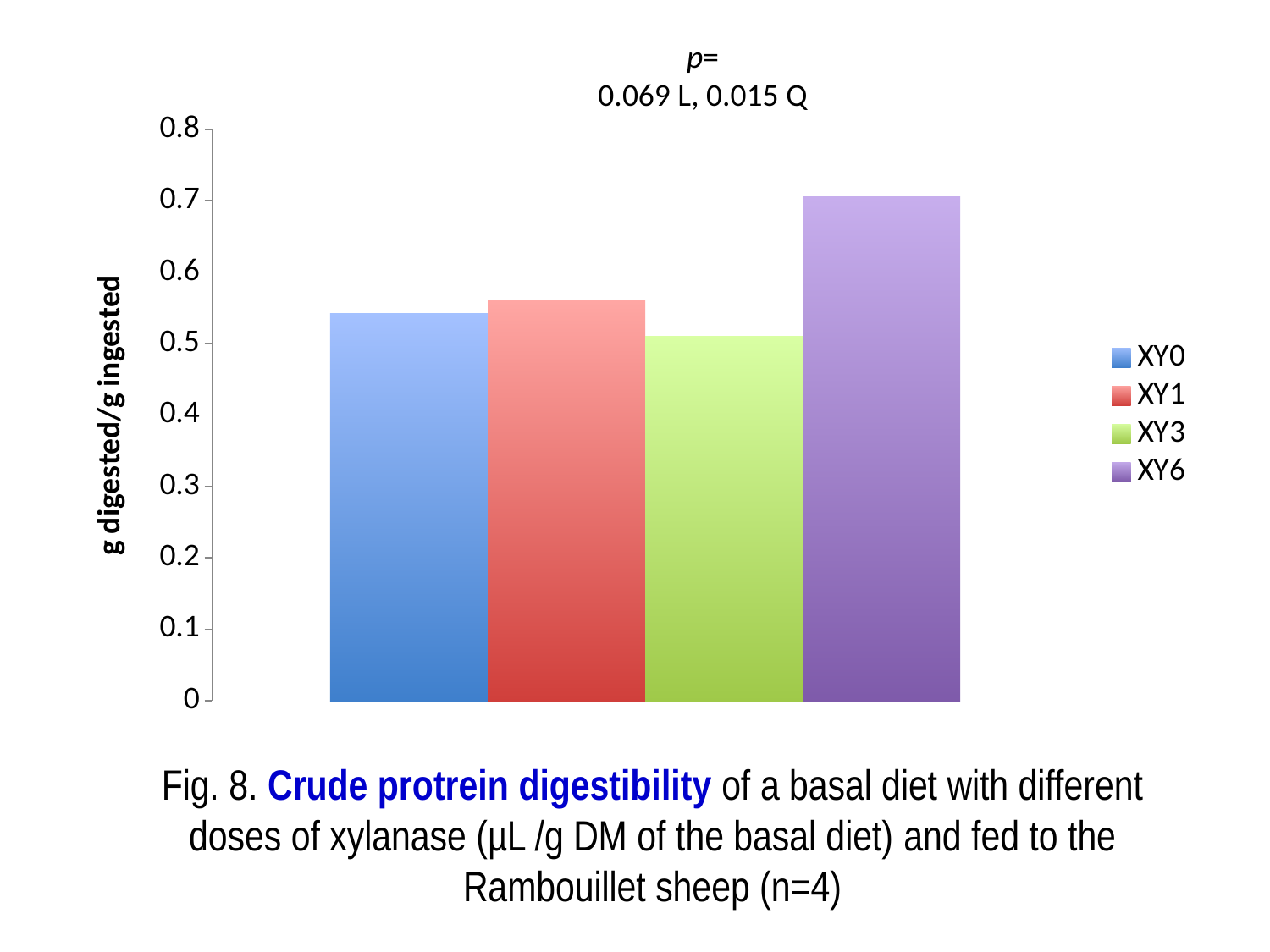
What kind of chart is shown on the slide? bar chart Which series has the lowest crude protein digestibility? XY3 What colour is the bar for XY6 in the chart? purple How many series does the legend list? 4 What is the label on the vertical axis of the chart? g digested/g ingested Is the value for XY3 greater or less than 0.6? less Which is larger, the value for XY1 or the value for XY3? XY1 Which is larger, the value for XY6 or the value for XY1? XY6 Is the value for XY0 greater or less than 0.5? greater Which series has the highest crude protein digestibility? XY6 How many bars are plotted in the chart? 4